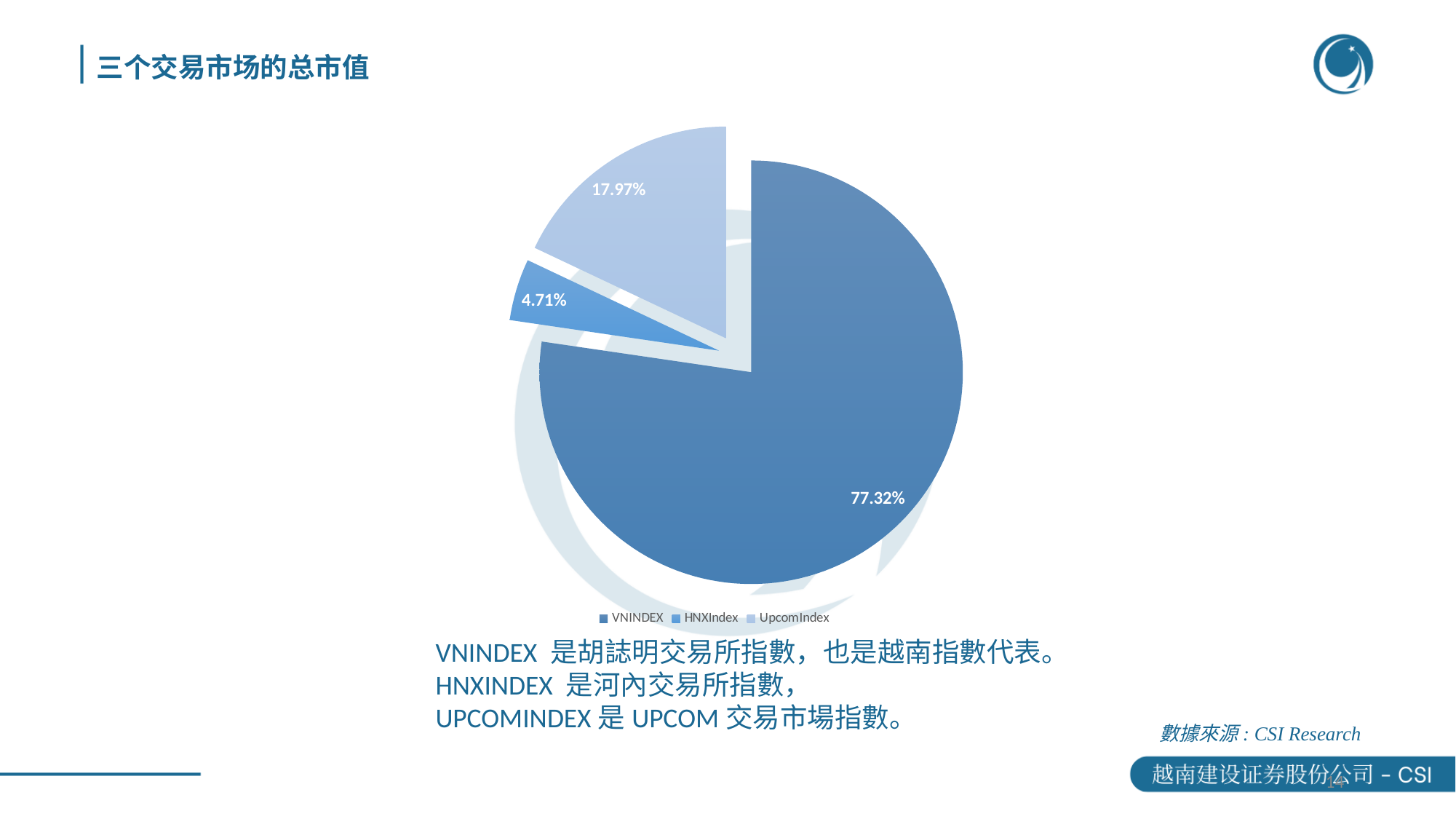
Which category has the smallest slice of the pie? HNXIndex How many entries does the legend list? 3 Which is larger, the UpcomIndex slice or the HNXIndex slice? UpcomIndex What is the difference in percentage points between the UpcomIndex slice and the HNXIndex slice? 13.26 What share of the pie does VNINDEX hold? 77.32% Which category has the largest slice of the pie? VNINDEX What share of the pie does UpcomIndex hold? 17.97% What is the difference in percentage points between the VNINDEX slice and the UpcomIndex slice? 59.35 What kind of chart is shown on the slide? Pie chart How many slices does the pie chart have? 3 What share of the pie does HNXIndex hold? 4.71% What is the title of the slide containing the pie chart? 三个交易市场的总市值